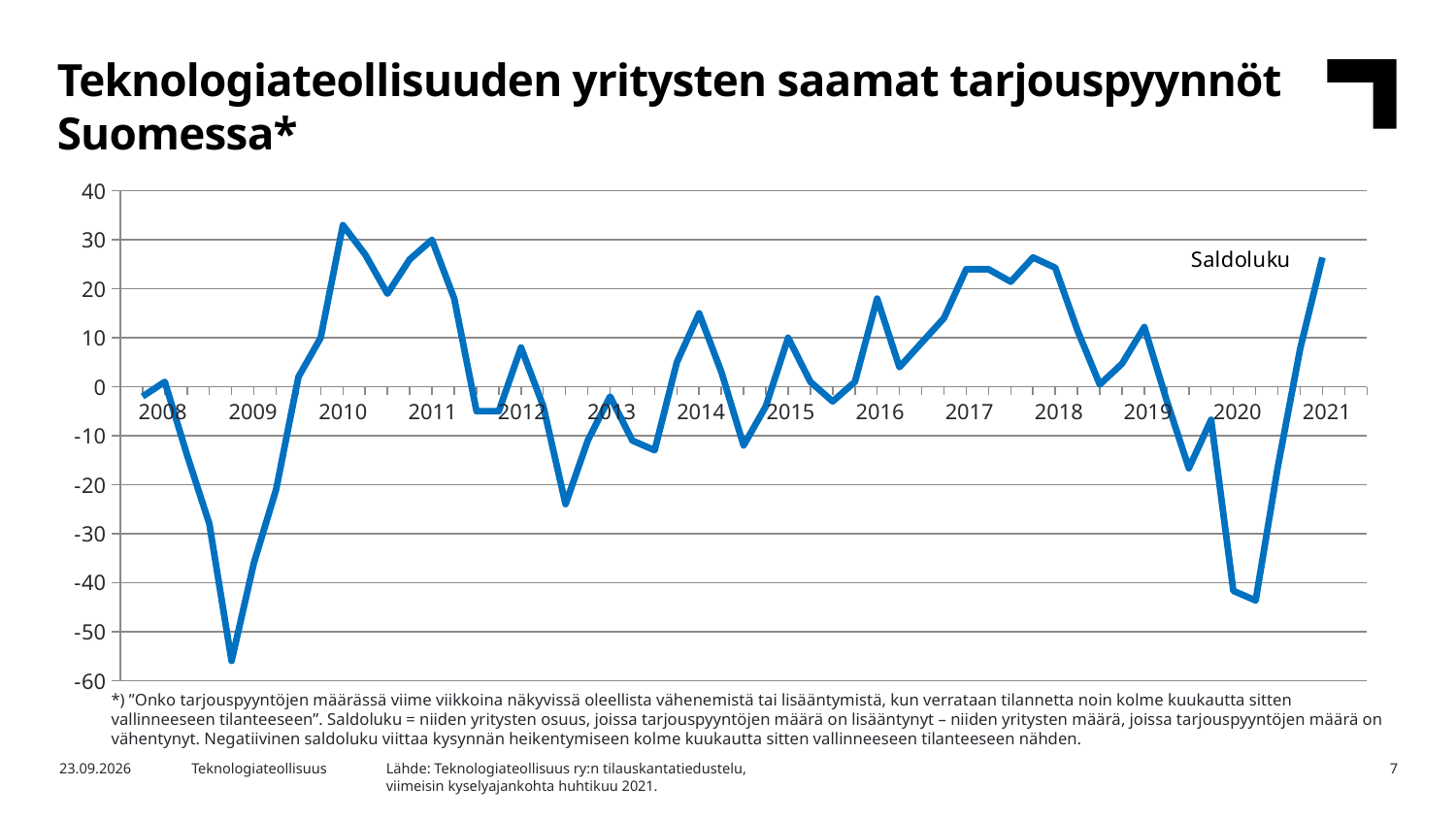
Does the line rise or fall from the start of 2008 to early 2009? Falls What kind of chart is shown on the slide? Line chart Which is lower: the trough in early 2009 or the trough in 2020? The trough in early 2009 Is the highest value on the chart, reached around 2010, greater or less than 30? greater Does the line rise or fall between the 2020 low and the final point at 2021? Rises Is the lowest value in 2020 greater or less than -40? less How many year labels are shown on the x axis? 14 What is the title of the chart on the slide? Teknologiateollisuuden yritysten saamat tarjouspyynnöt Suomessa* Is the lowest value on the chart, reached in early 2009, greater or less than -50? less What is the name of the series plotted on the chart? Saldoluku How many series does the chart show? 1